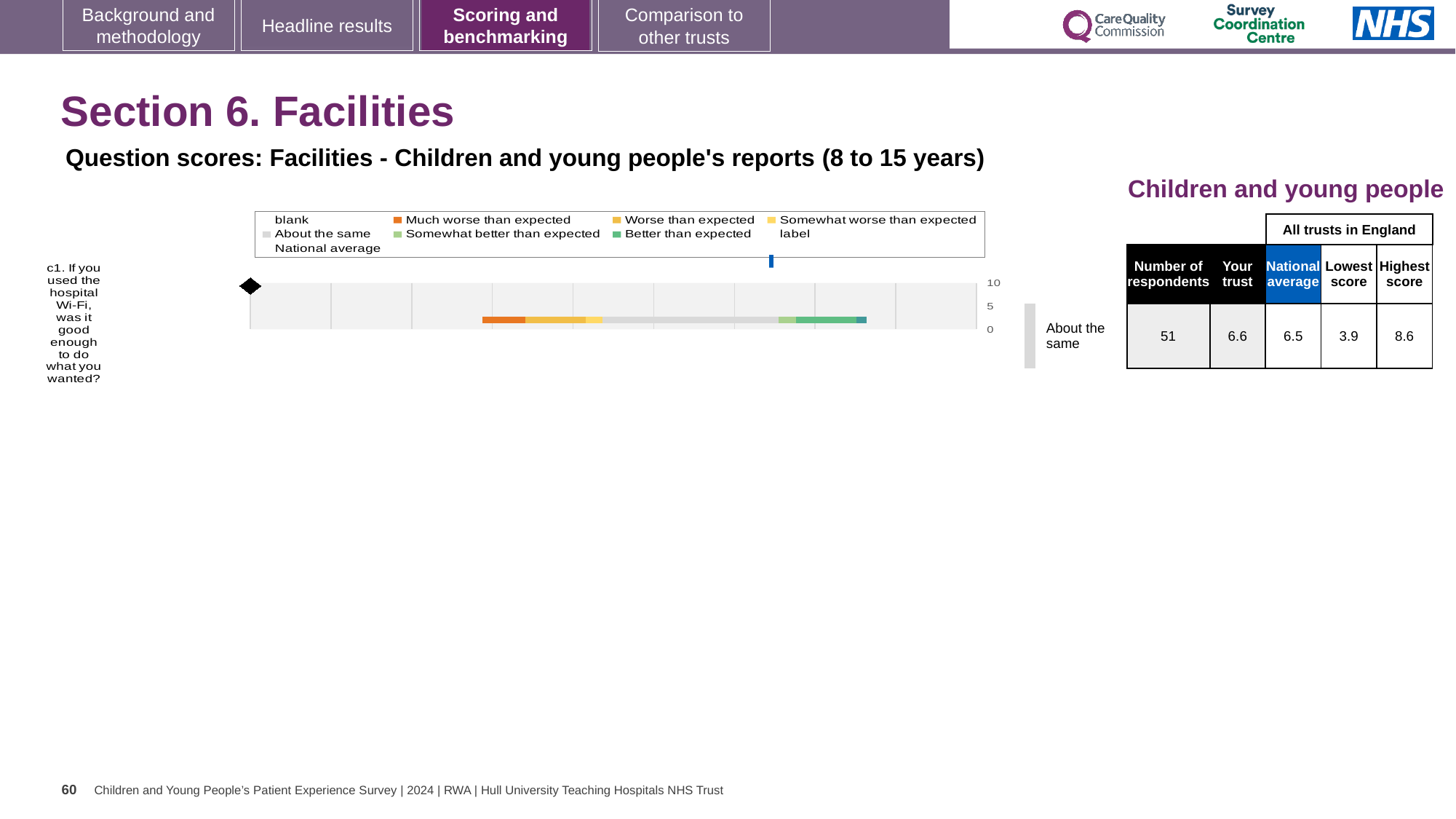
What is the national average score for question c1? 6.5 What kind of chart is shown on the slide? bar chart How many survey questions (categories) are plotted in the chart? 1 Which benchmark category is the trust's result for question c1 placed in? About the same How many respondents answered question c1? 51 What is the 'Your trust' score for question c1 about the hospital Wi-Fi? 6.6 Which legend entry is shown in orange? Much worse than expected What is the lowest score among all trusts in England for question c1? 3.9 Which is larger for question c1: the trust's score or the national average? the trust's score What is the difference between the highest and lowest scores for question c1? 4.7 What is the highest score among all trusts in England for question c1? 8.6 What is the highest value shown on the chart's axis? 10